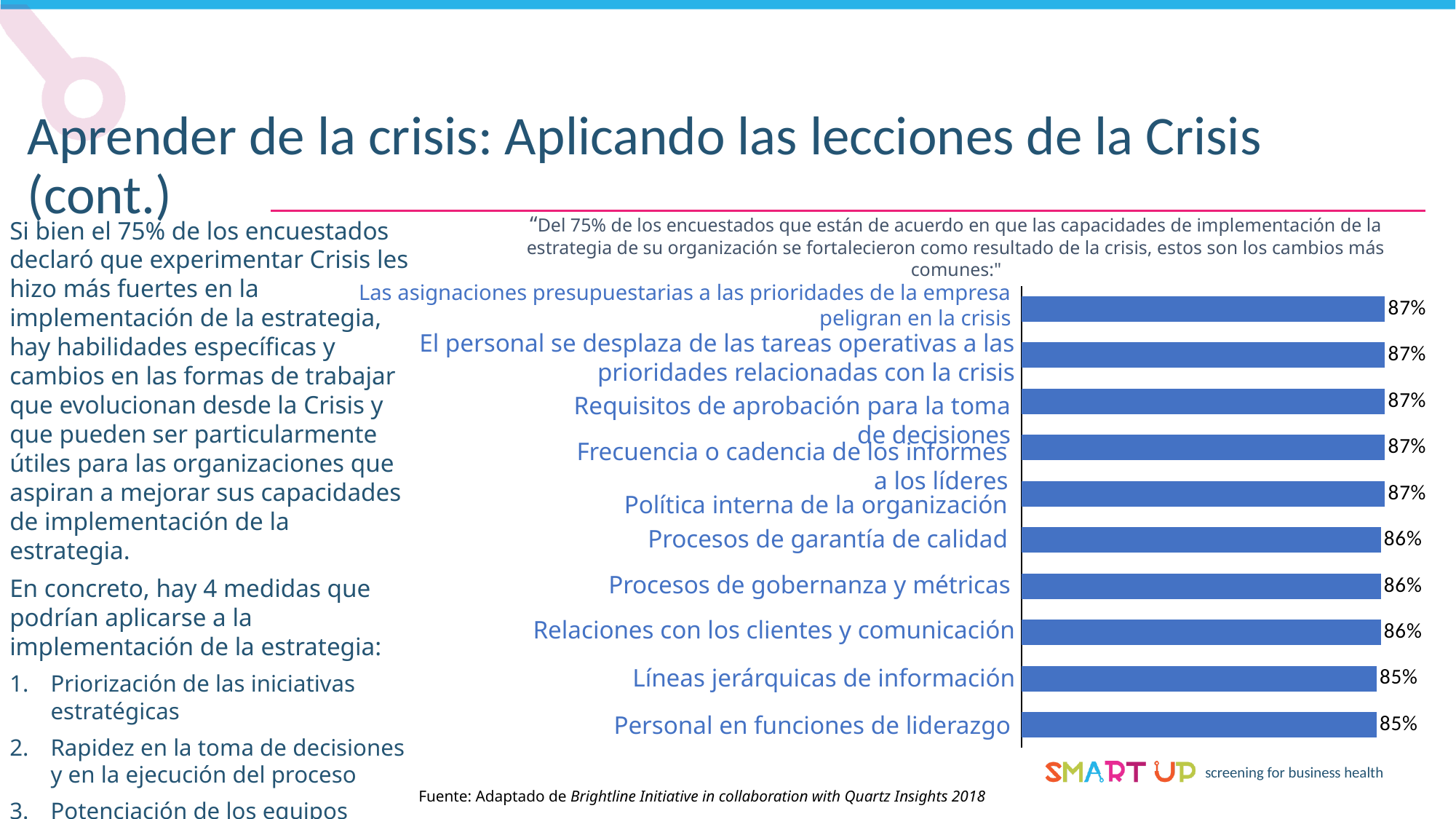
What kind of chart is shown on the slide? Bar chart How many categories are plotted in the chart? 10 What is the lowest value shown in the chart? 85% What value is shown for "Relaciones con los clientes y comunicación"? 86% Which has the larger value: "Procesos de gobernanza y métricas" or "Líneas jerárquicas de información"? Procesos de gobernanza y métricas How many categories in the chart have a value of 87%? 5 What value is shown for "Personal en funciones de liderazgo"? 85% What value is shown for "Líneas jerárquicas de información"? 85% What colour are the bars in the chart? Blue What is the difference between the values for "Política interna de la organización" and "Personal en funciones de liderazgo"? 2 percentage points What value is shown for "Procesos de garantía de calidad"? 86% What value is shown for "Política interna de la organización"? 87%